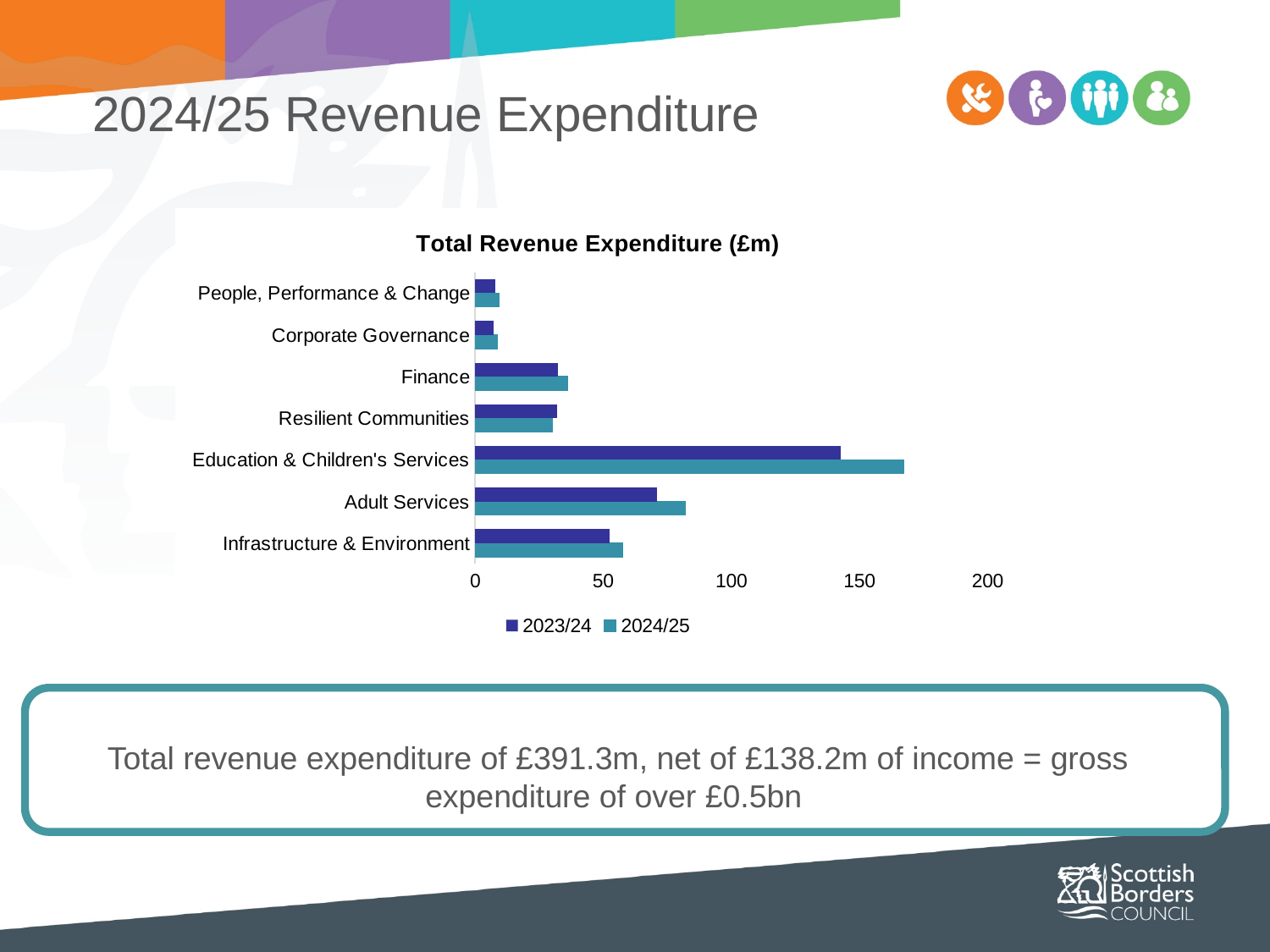
What is the title of the chart? Total Revenue Expenditure (£m) Is the 2024/25 value for Finance greater or less than 50? less Is the 2024/25 value for Adult Services greater or less than 50? greater Is the 2023/24 value for Education & Children's Services greater or less than 150? less Which category has the highest 2024/25 revenue expenditure? Education & Children's Services How many series does the chart's legend list? 2 For 2024/25, which is larger: Adult Services or Infrastructure & Environment? Adult Services Which two series are listed in the chart's legend? 2023/24 and 2024/25 What kind of chart is shown on the slide? Bar chart How many service categories are shown on the chart? 7 For Education & Children's Services, which is larger: the 2023/24 value or the 2024/25 value? 2024/25